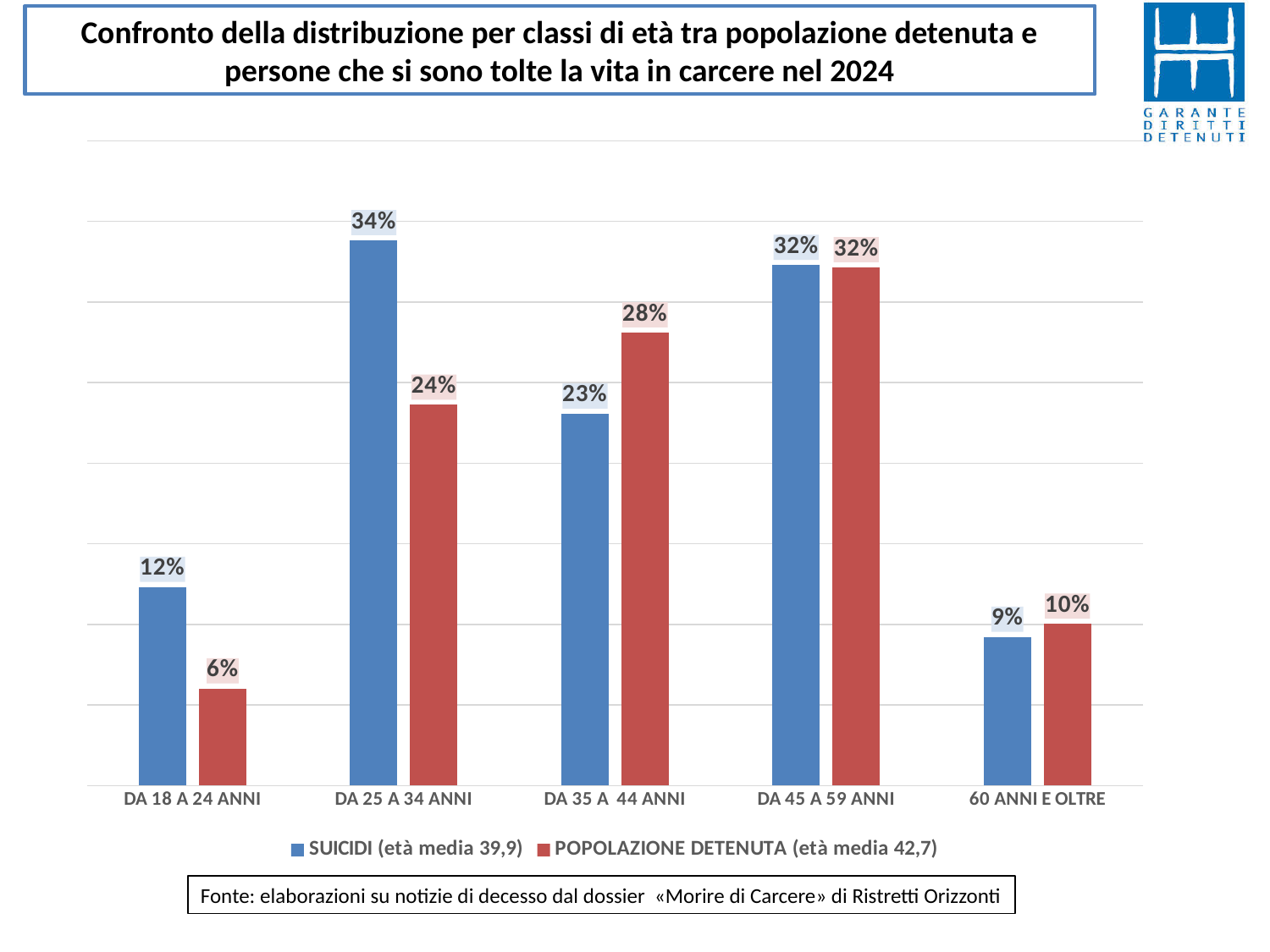
Which age category has the highest value for SUICIDI? DA 25 A 34 ANNI How many series does the legend list? 2 What is the value for SUICIDI in the 60 ANNI E OLTRE category? 9% What is the value for SUICIDI in the DA 25 A 34 ANNI category? 34% What is the difference between SUICIDI and POPOLAZIONE DETENUTA in the DA 25 A 34 ANNI category? 10% What is the value for POPOLAZIONE DETENUTA in the DA 35 A 44 ANNI category? 28% What is the value for POPOLAZIONE DETENUTA in the DA 18 A 24 ANNI category? 6% What kind of chart is shown on the slide? Bar chart Which is larger in the DA 35 A 44 ANNI category: SUICIDI or POPOLAZIONE DETENUTA? POPOLAZIONE DETENUTA Which age category has the lowest value for POPOLAZIONE DETENUTA? DA 18 A 24 ANNI How many age categories are shown on the x axis? 5 What average age is given in the legend for the SUICIDI series? 39,9